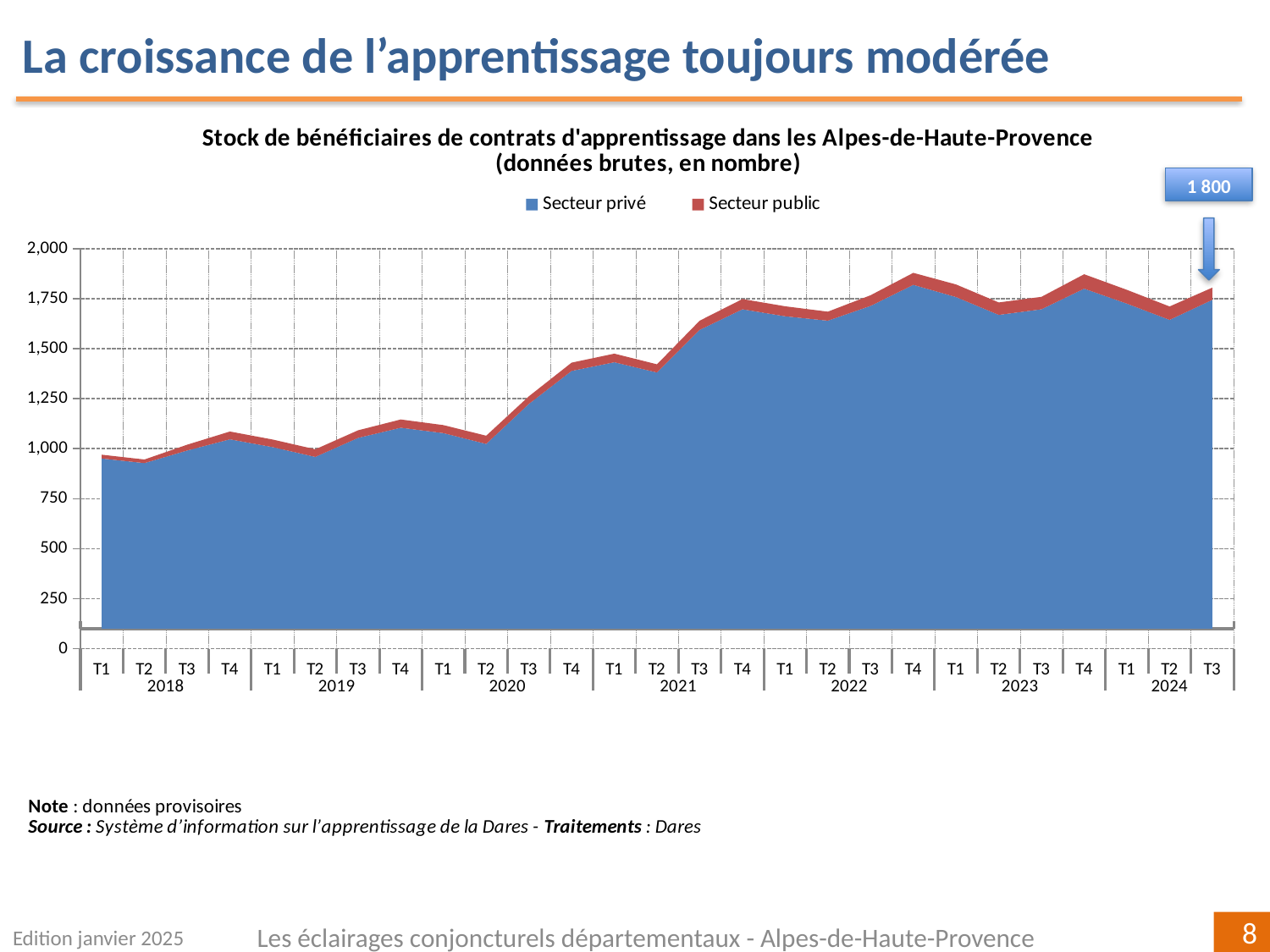
What are the two series named in the legend? Secteur privé and Secteur public Is the total value for T1 2018 greater or less than 1,000? less Is the total value for T1 2021 greater or less than 1,250? greater What kind of chart is shown on the slide? Area chart Overall, do the values rise or fall from 2018 to 2024? Rise Which is larger, the total for T4 2022 or the total for T1 2018? T4 2022 What total value does the callout give for the last point, T3 2024? 1 800 How many quarterly data points are plotted along the x axis? 27 Is the total value for T4 2022 greater or less than 1,750? greater Which series accounts for the larger share of the stock in every quarter, Secteur privé or Secteur public? Secteur privé How many series does the legend list? 2